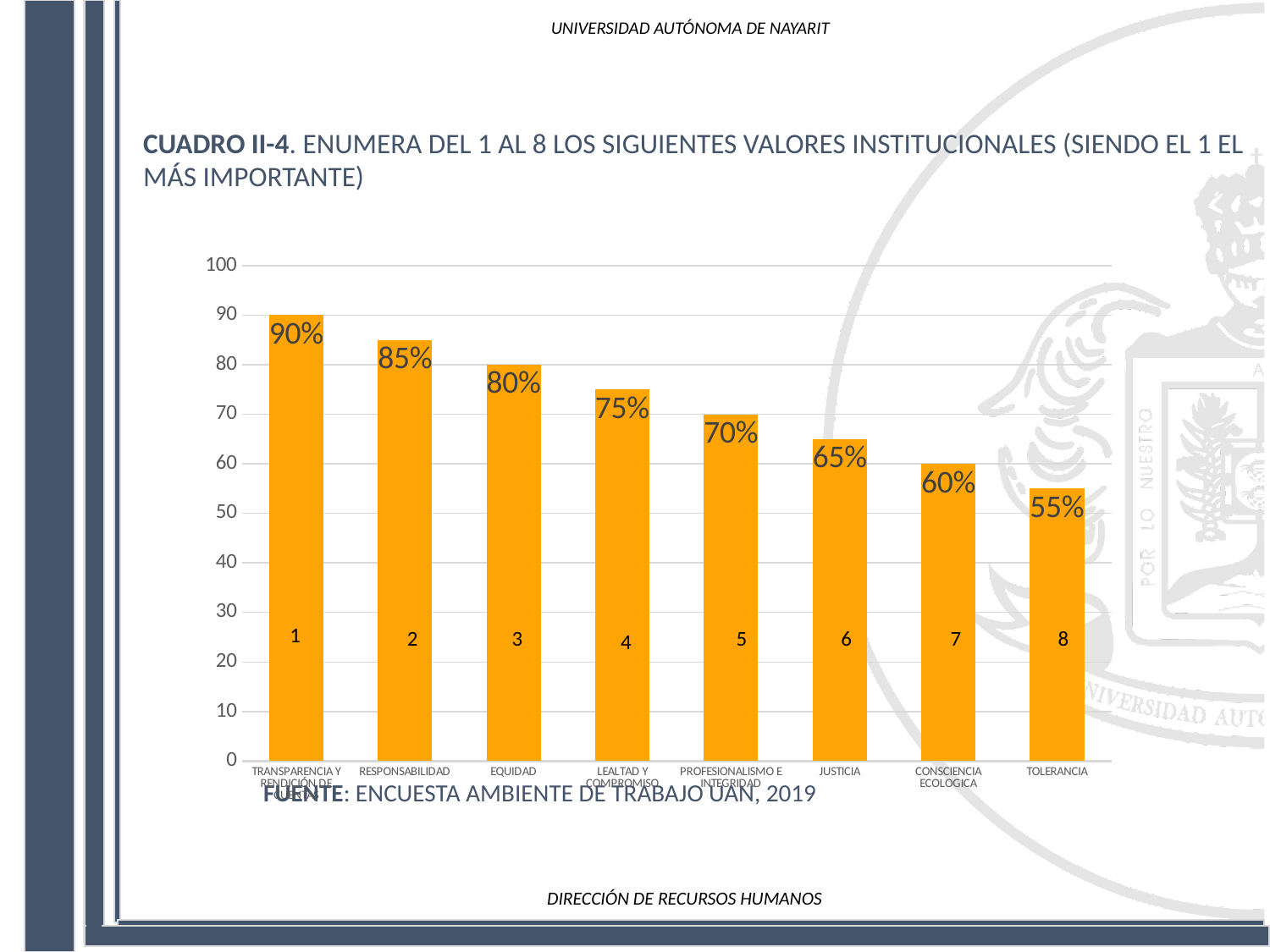
Do the values rise or fall from left to right along the x axis? fall Which category has the lowest value? TOLERANCIA Which is larger, the value for LEALTAD Y COMPROMISO or the value for PROFESIONALISMO E INTEGRIDAD? LEALTAD Y COMPROMISO Which category has the highest value? TRANSPARENCIA Y RENDICIÓN DE CUENTAS What rank number is printed inside the bar for PROFESIONALISMO E INTEGRIDAD? 5 What is the value for EQUIDAD? 80% What is the value for TOLERANCIA? 55% What is the value for JUSTICIA? 65% Is the value for JUSTICIA greater or less than 70? less What is the difference between the values for RESPONSABILIDAD and CONSCIENCIA ECOLÓGICA? 25% How many categories are shown in the chart? 8 What kind of chart is shown on the slide? bar chart